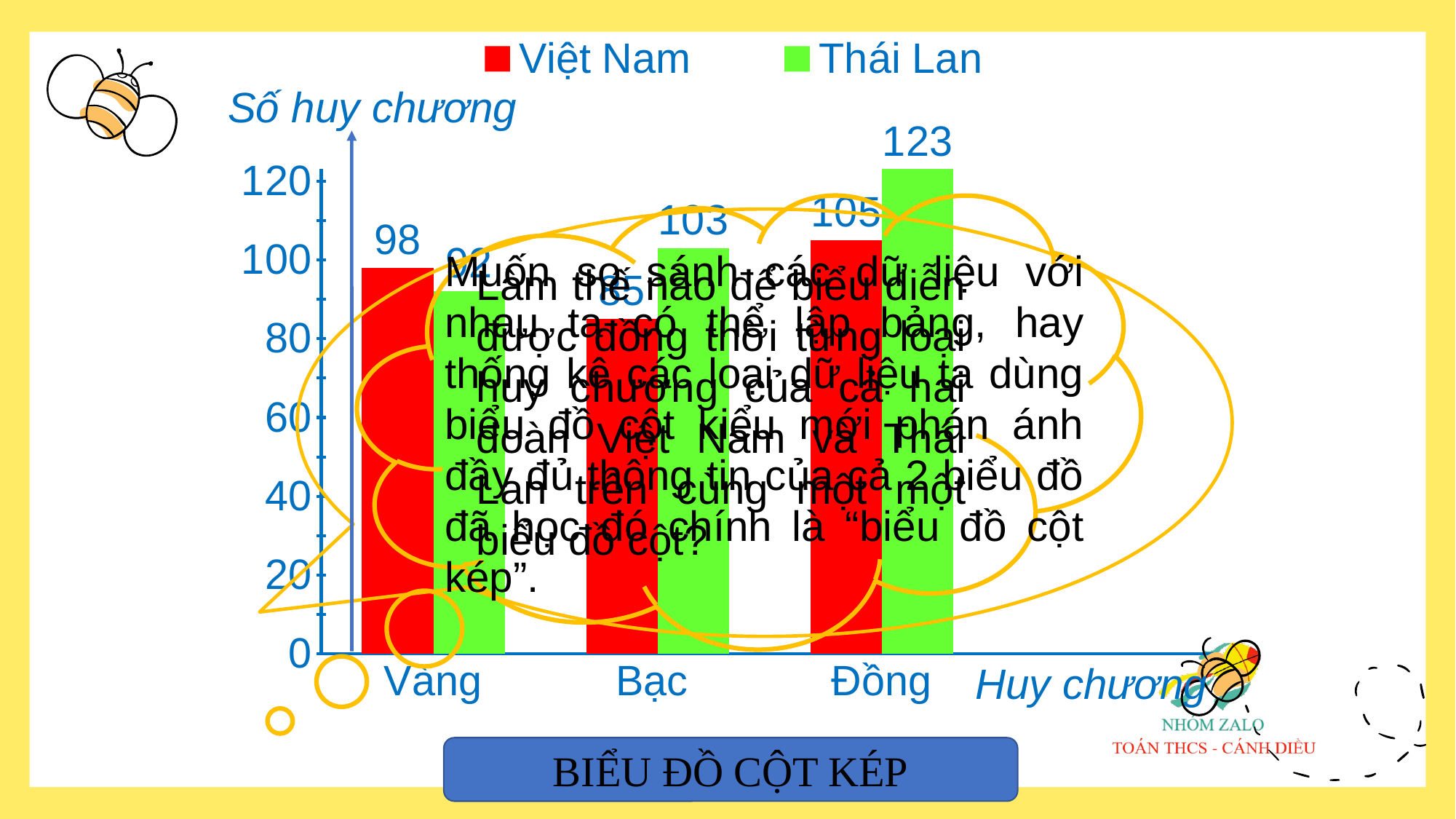
What kind of chart is shown on the slide? bar chart How many series does the legend list? 2 Which category has the highest value for Thái Lan? Đồng In the Đồng category, which series has the larger value, Việt Nam or Thái Lan? Thái Lan Is the value for Việt Nam in the Bạc category greater or less than 100? less What is the value for Việt Nam in the Vàng category? 98 What is the difference between the Thái Lan and Việt Nam values in the Đồng category? 18 What is the value for Thái Lan in the Đồng category? 123 How many categories are shown on the x axis? 3 What is the value for Việt Nam in the Đồng category? 105 In the Vàng category, which series has the larger value, Việt Nam or Thái Lan? Việt Nam What is the value for Thái Lan in the Bạc category? 103